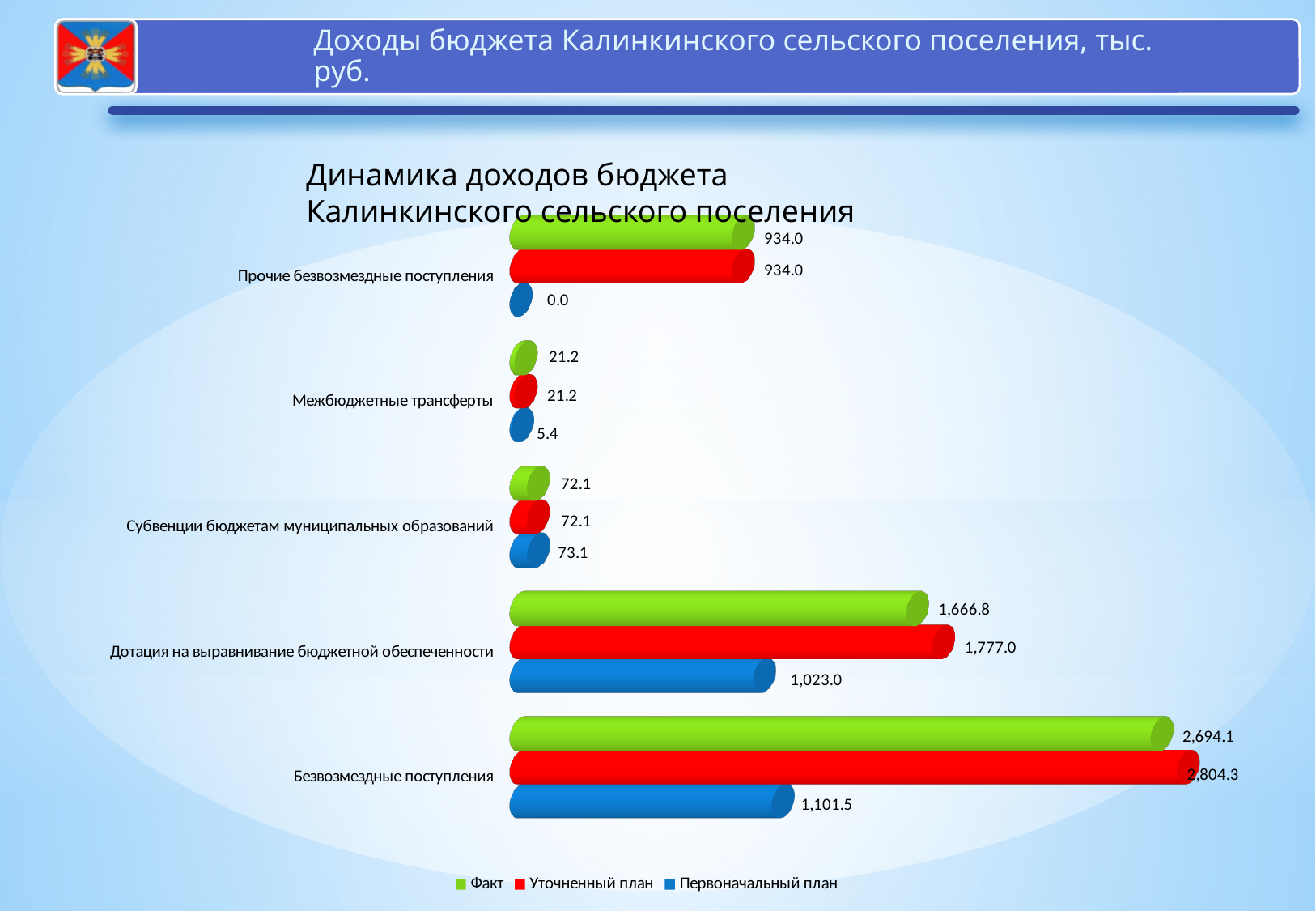
What is the difference between the Уточненный план and Факт values for Дотация на выравнивание бюджетной обеспеченности? 110.2 What is the Первоначальный план value for Дотация на выравнивание бюджетной обеспеченности? 1,023.0 What is the Факт value for Безвозмездные поступления? 2,694.1 What is the Уточненный план value for Межбюджетные трансферты? 21.2 How many categories are shown on the chart? 5 Which category has the lowest Первоначальный план value? Прочие безвозмездные поступления What is the difference between the Уточненный план and Первоначальный план values for Безвозмездные поступления? 1,702.8 How many series does the legend list? 3 What is the Первоначальный план value for Прочие безвозмездные поступления? 0.0 What kind of chart is shown on the slide? Bar chart Which is larger for Безвозмездные поступления: the Факт value or the Первоначальный план value? Факт Which category has the highest Уточненный план value? Безвозмездные поступления